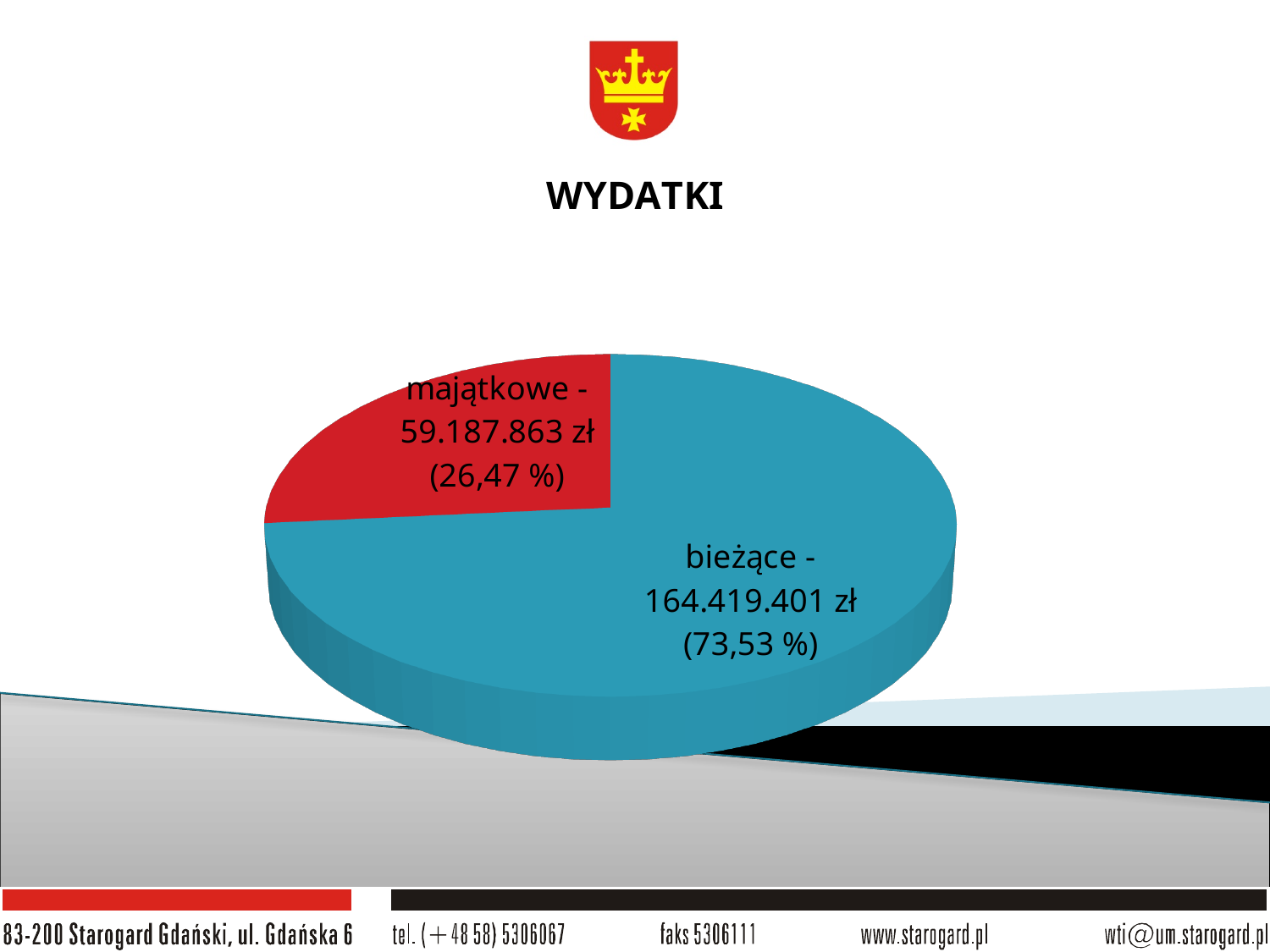
What share of the pie does majątkowe represent? 26,47 % What is the title of the chart? WYDATKI What colour is the majątkowe slice? red Which category has the largest slice? bieżące Which category has the smallest slice? majątkowe What kind of chart is shown on the slide? pie chart What share of the pie does bieżące represent? 73,53 % What is the difference between the values for bieżące and majątkowe? 105.231.538 zł Which is larger, bieżące or majątkowe? bieżące What is the value for bieżące? 164.419.401 zł What is the value for majątkowe? 59.187.863 zł How many slices does the pie chart have? 2